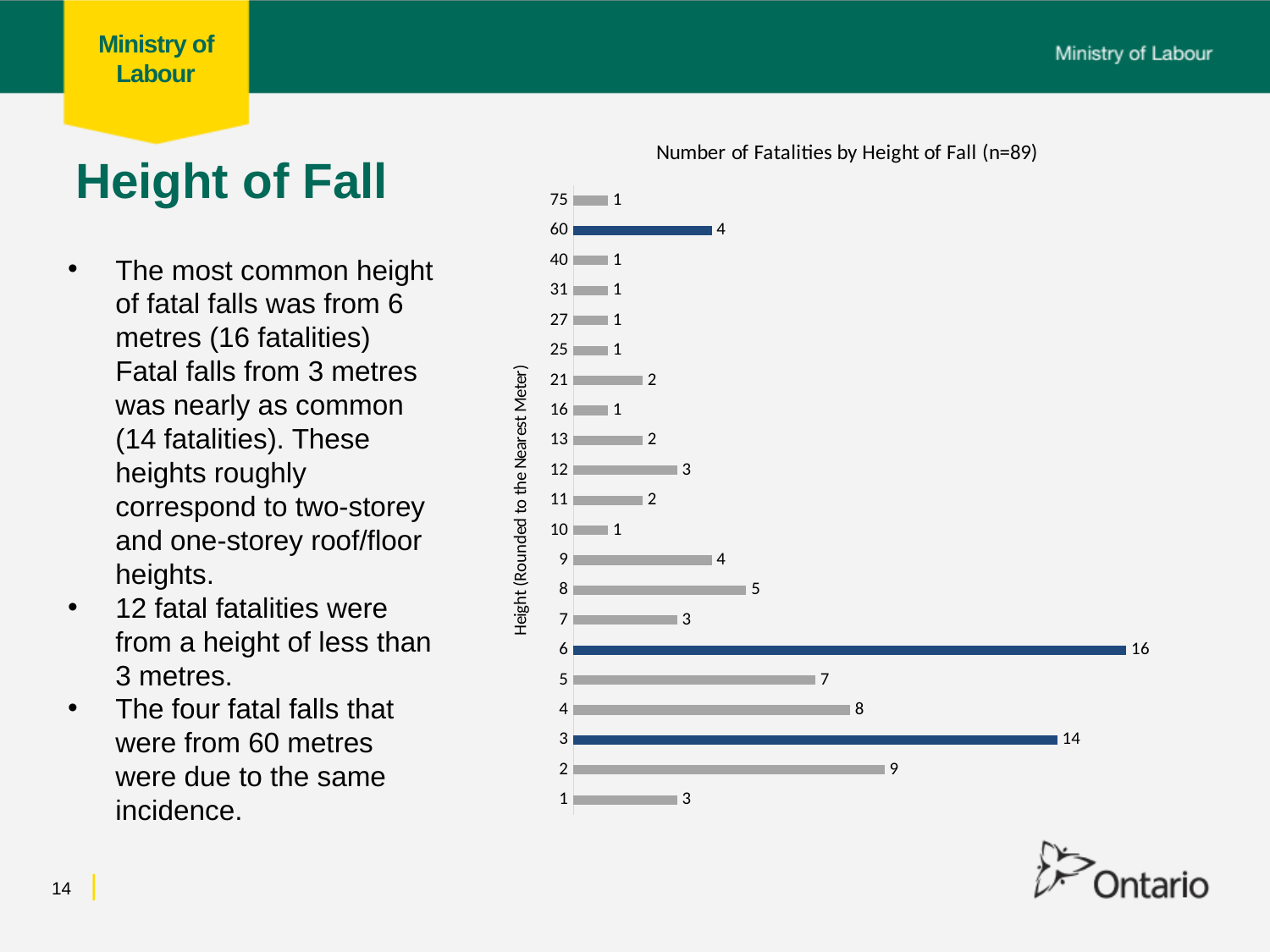
What is the title of the chart? Number of Fatalities by Height of Fall (n=89) Which has more fatalities: falls from 4 metres or falls from 5 metres? 4 metres How many height categories are shown on the chart? 21 How many fatalities were from a height of 3 metres? 14 What is the difference in fatalities between falls from 8 metres and falls from 7 metres? 2 What is the label of the vertical axis? Height (Rounded to the Nearest Meter) What is the difference in fatalities between falls from 6 metres and falls from 3 metres? 2 Which height of fall has the highest number of fatalities? 6 How many fatalities were from a height of 60 metres? 4 How many fatalities were from a height of 2 metres? 9 What kind of chart is shown on the slide? bar chart How many fatalities were from a height of 6 metres? 16